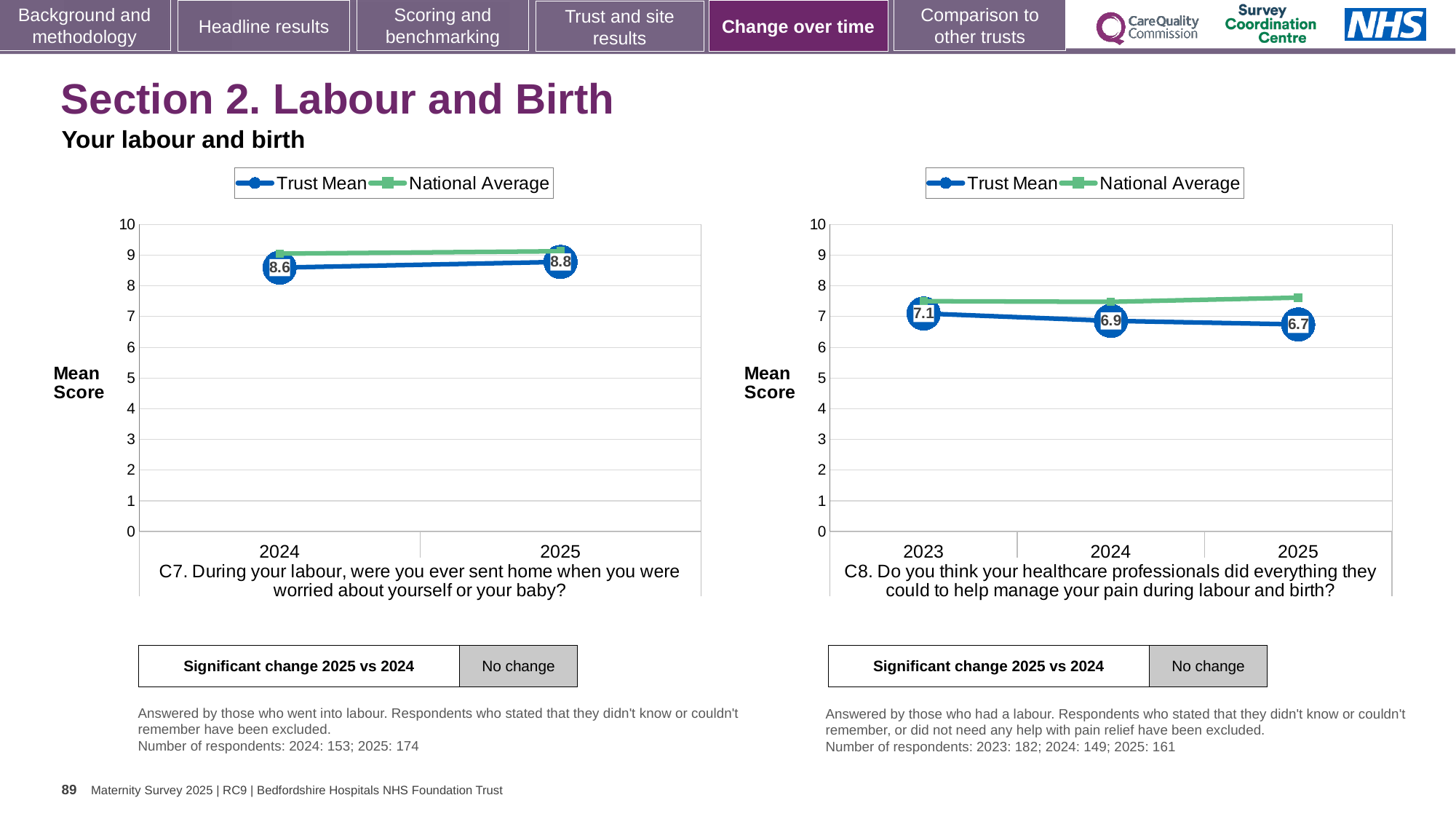
In the C7 chart on the left, what is the Trust Mean score for 2024? 8.6 In the C7 chart on the left, does the Trust Mean rise or fall from 2024 to 2025? rise In the C7 chart on the left, what is the Trust Mean score for 2025? 8.8 How many series does the legend of the C7 chart on the left list? 2 In the C8 chart on the right, which is higher in 2024, the Trust Mean or the National Average? National Average How many years are plotted on the x axis of the C8 chart on the right? 3 In the C8 chart on the right, does the Trust Mean rise or fall from 2023 to 2025? fall In the C8 chart on the right, what is the Trust Mean score for 2023? 7.1 In the C8 chart on the right, what is the Trust Mean score for 2025? 6.7 In the C8 chart on the right, what is the difference between the Trust Mean scores for 2023 and 2025? 0.4 In the C8 chart on the right, which year has the lowest Trust Mean score? 2025 In the C8 chart on the right, is the National Average for 2025 greater or less than 7? greater